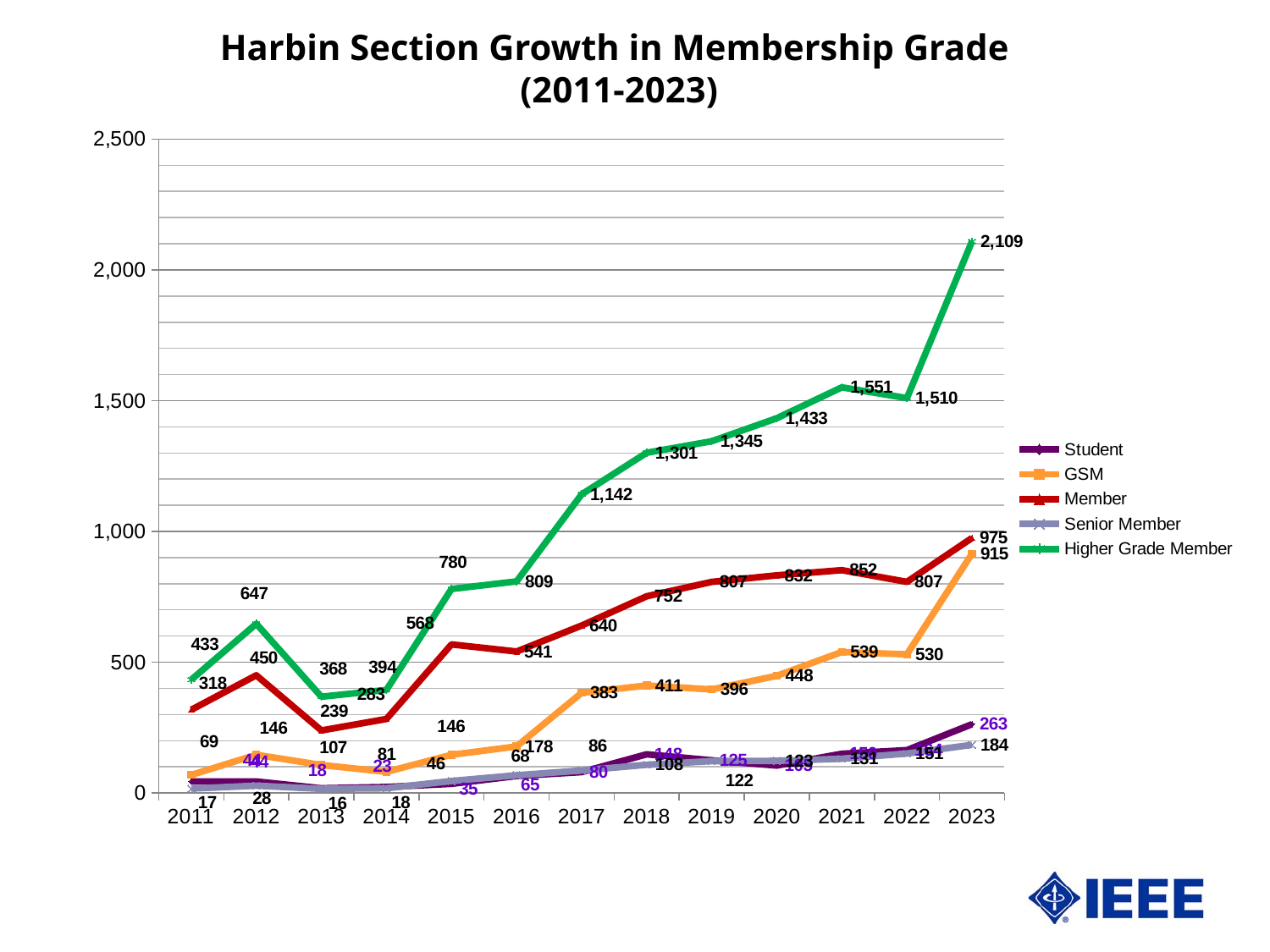
What is the value for Member in 2018? 752 What is the value for GSM in 2021? 539 Is the value for Higher Grade Member in 2021 greater or less than 1,500? greater What is the value for Student in 2023? 263 How many years are plotted on the x axis? 13 What is the value for Higher Grade Member in 2023? 2,109 In which year is the Higher Grade Member value highest? 2023 What kind of chart is shown on the slide? Line chart Which is larger in 2023, the Member value or the GSM value? Member What is the difference between the Higher Grade Member values in 2023 and 2022? 599 In which year is the Higher Grade Member value lowest? 2013 How many series does the legend list? 5